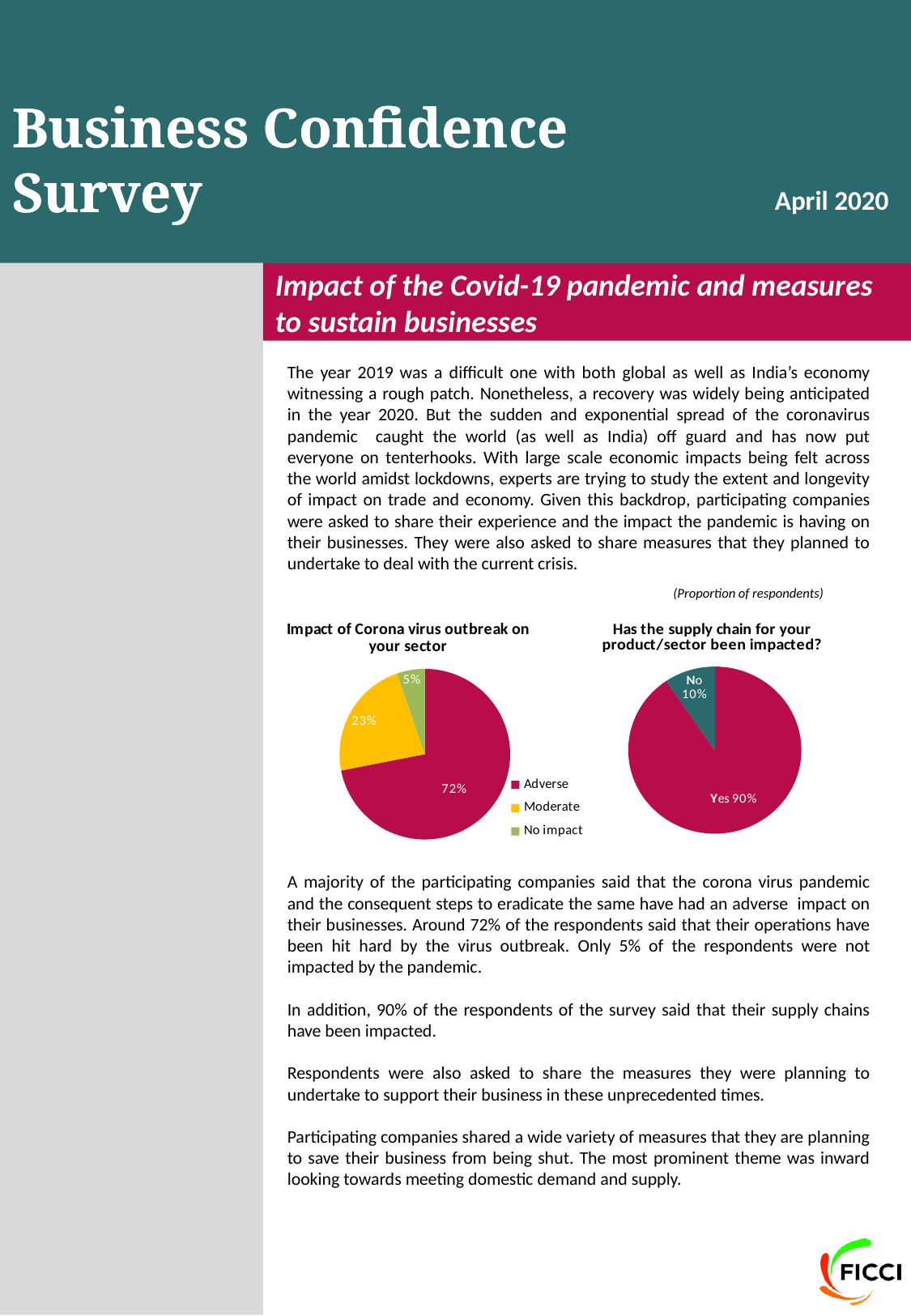
In the chart 'Impact of Corona virus outbreak on your sector', what share of respondents reported a moderate impact? 23% In the chart 'Impact of Corona virus outbreak on your sector', what colour represents the Moderate category? Yellow In the chart 'Impact of Corona virus outbreak on your sector', what share of respondents reported an adverse impact? 72% In the chart 'Has the supply chain for your product/sector been impacted?', what share of respondents answered No? 10% In the chart 'Has the supply chain for your product/sector been impacted?', which is larger, the Yes share or the No share? Yes In the chart 'Impact of Corona virus outbreak on your sector', what share of respondents reported no impact? 5% In the chart 'Impact of Corona virus outbreak on your sector', how many categories are shown in the legend? 3 In the chart 'Impact of Corona virus outbreak on your sector', which category has the smallest share? No impact In the chart 'Has the supply chain for your product/sector been impacted?', what share of respondents answered Yes? 90% In the chart 'Impact of Corona virus outbreak on your sector', which category has the largest share? Adverse In the chart 'Impact of Corona virus outbreak on your sector', what is the difference in percentage points between the Adverse and Moderate shares? 49 percentage points What type of chart is 'Has the supply chain for your product/sector been impacted?'? Pie chart